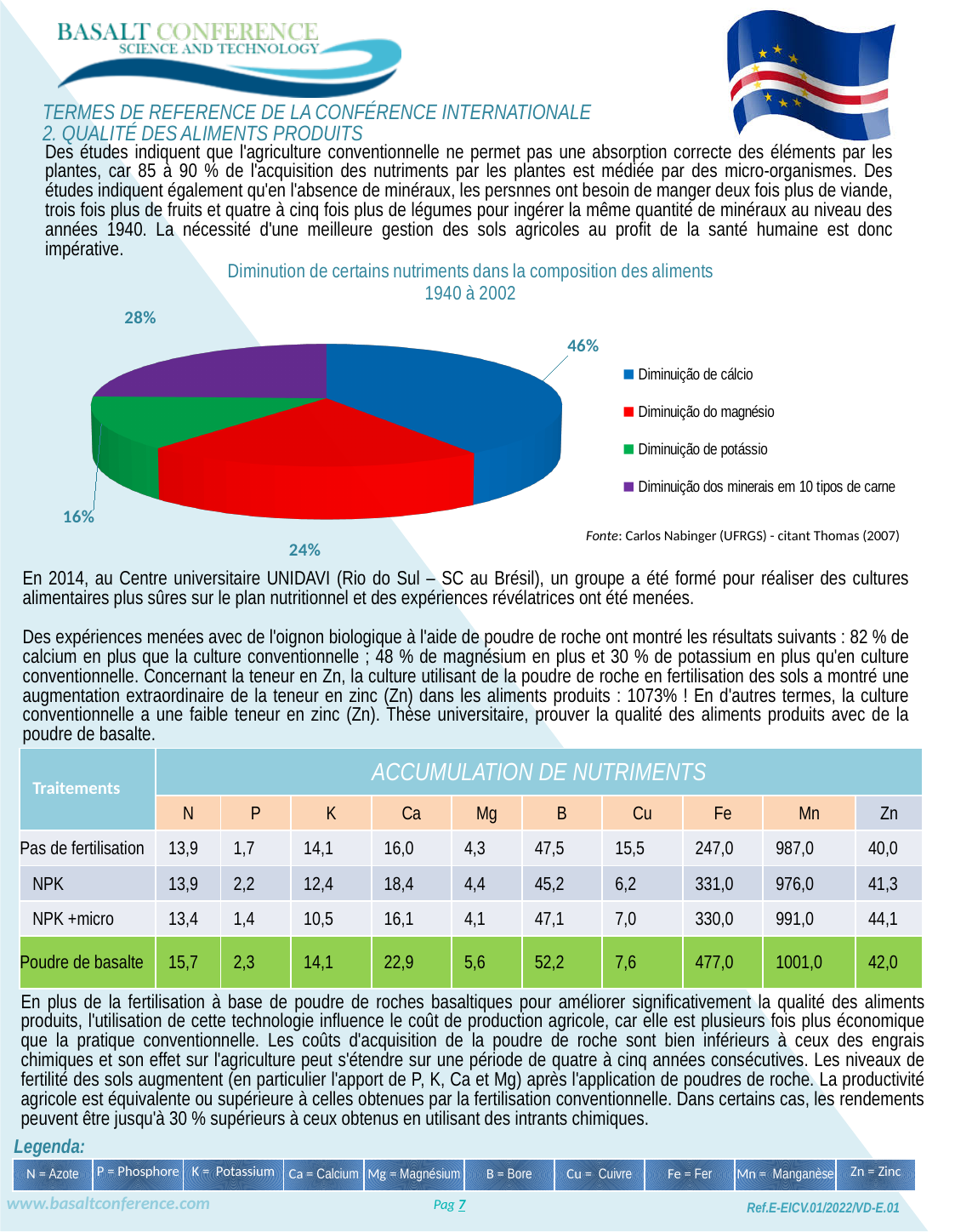
Which is larger in the pie chart: "Diminuição do magnésio" or "Diminuição de potássio"? Diminuição do magnésio What percentage is shown for "Diminuição de cálcio" in the pie chart? 46% What is the title of the pie chart? Diminution de certains nutriments dans la composition des aliments 1940 à 2002 What percentage is shown for "Diminuição de potássio" in the pie chart? 16% What colour is the slice for "Diminuição dos minerais em 10 tipos de carne"? purple How many entries does the legend of the pie chart list? 4 What is the difference in percentage points between "Diminuição de cálcio" and "Diminuição do magnésio"? 22 Which category has the largest slice in the pie chart? Diminuição de cálcio What percentage is shown for "Diminuição dos minerais em 10 tipos de carne" in the pie chart? 28% Which category has the smallest slice in the pie chart? Diminuição de potássio What percentage is shown for "Diminuição do magnésio" in the pie chart? 24% What kind of chart is shown on the slide? pie chart